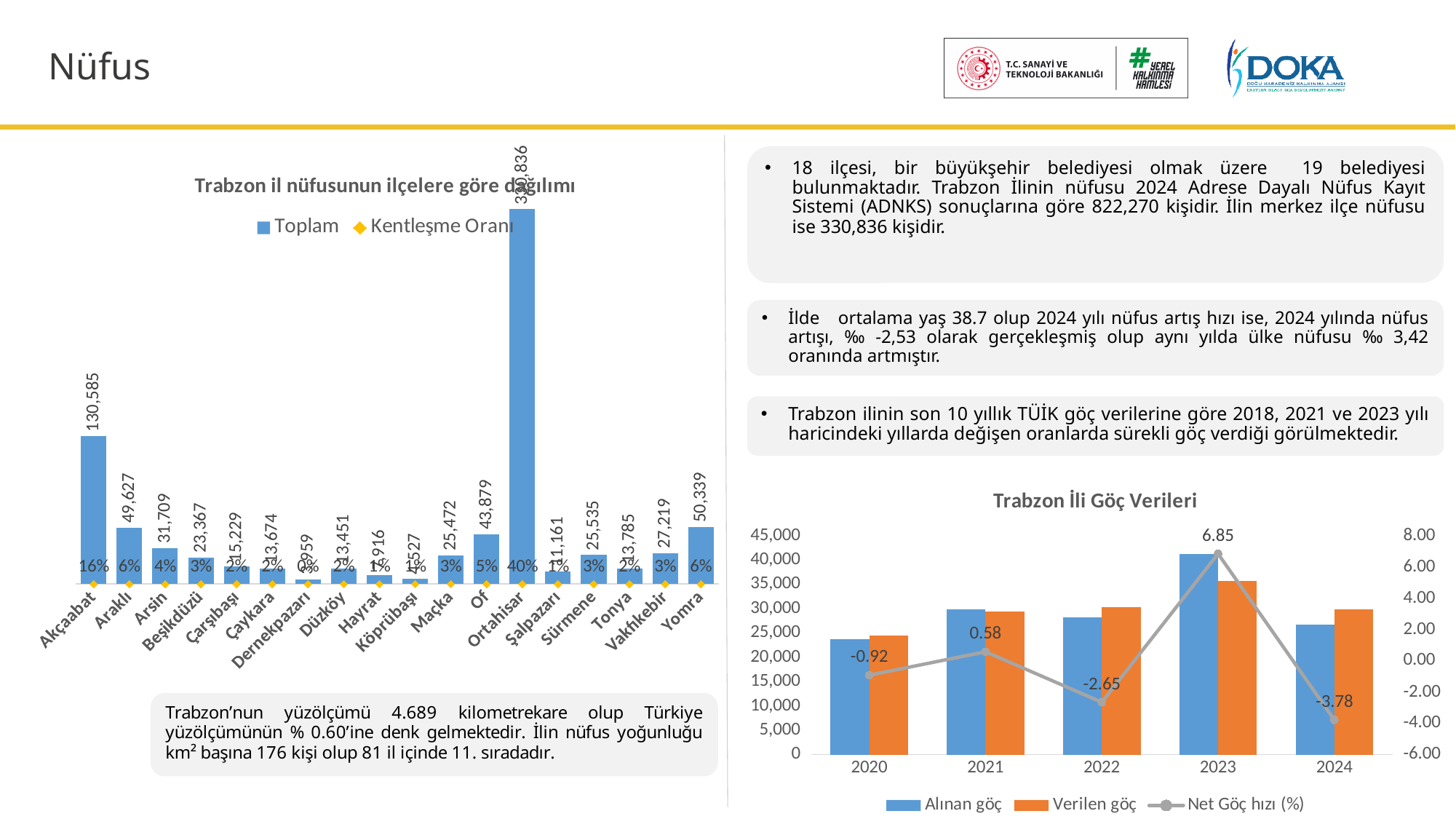
In the chart 'Trabzon İli Göç Verileri', is the Alınan göç value for 2020 greater or less than 25,000? less In the chart 'Trabzon İli Göç Verileri', what is the Net Göç hızı (%) value for 2023? 6.85 In the chart 'Trabzon il nüfusunun ilçelere göre dağılımı', what is the difference between the Toplam values of Yomra and Araklı? 712 How many districts are shown in the chart 'Trabzon il nüfusunun ilçelere göre dağılımı'? 18 In the chart 'Trabzon il nüfusunun ilçelere göre dağılımı', which district has the lowest Toplam value? Dernekpazarı In the chart 'Trabzon il nüfusunun ilçelere göre dağılımı', which district has the highest Toplam value? Ortahisar In the chart 'Trabzon İli Göç Verileri', what is the difference between the Net Göç hızı (%) values for 2021 and 2020? 1.50 In the chart 'Trabzon il nüfusunun ilçelere göre dağılımı', what is the Toplam value for Akçaabat? 130,585 In the chart 'Trabzon İli Göç Verileri', which year has the lowest Net Göç hızı (%)? 2024 In the chart 'Trabzon il nüfusunun ilçelere göre dağılımı', what is the Kentleşme Oranı for Ortahisar? 40% How many series does the legend of the chart 'Trabzon İli Göç Verileri' list? 3 In the chart 'Trabzon il nüfusunun ilçelere göre dağılımı', which has a larger Toplam value, Of or Arsin? Of